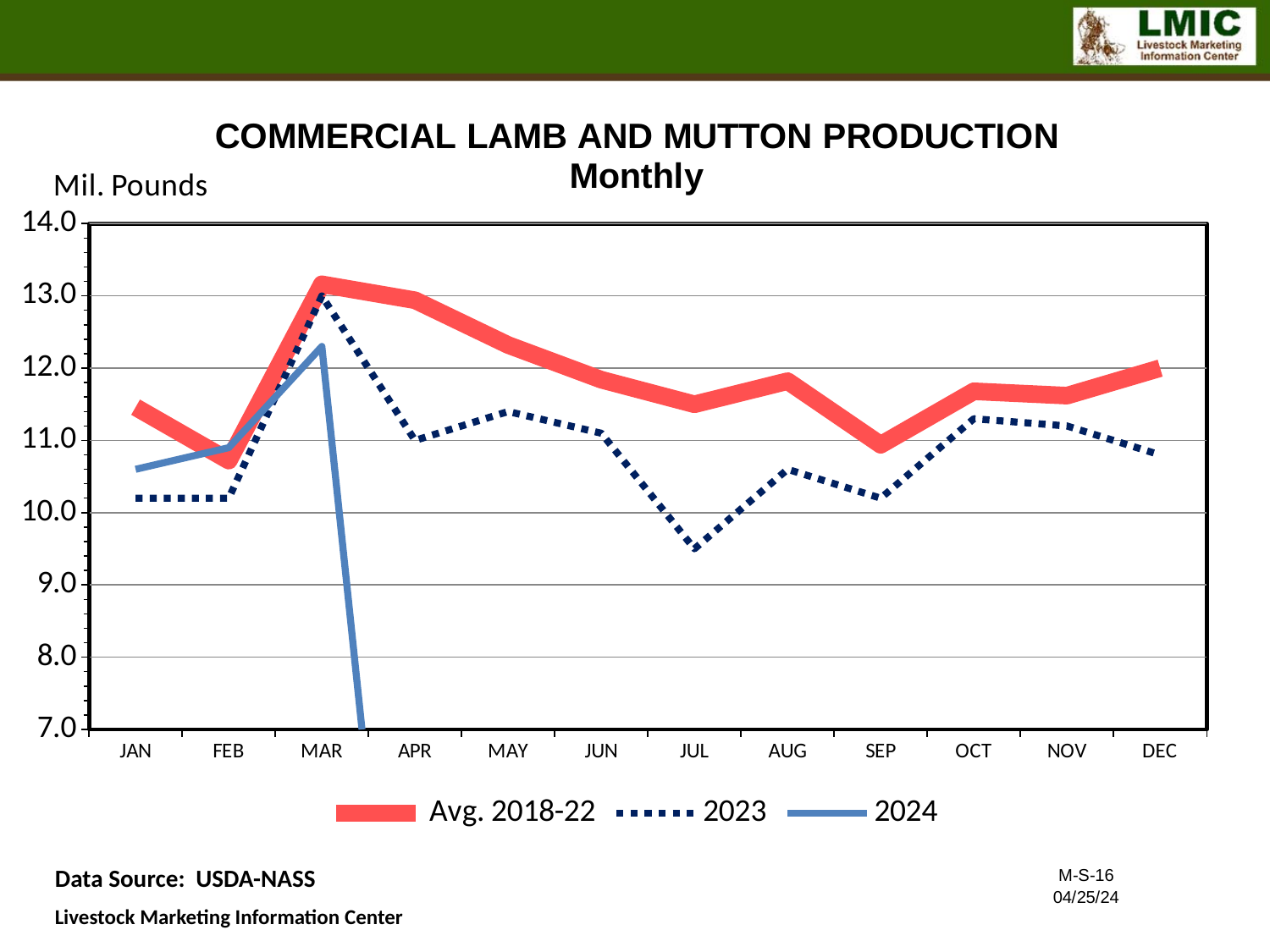
What unit is shown on the y axis label? Mil. Pounds In APR, which series is higher: Avg. 2018-22 or 2023? Avg. 2018-22 Is the Avg. 2018-22 value for JUL greater or less than 11.0? greater Is the 2023 value for JUL greater or less than 10.0? less In which month does the Avg. 2018-22 series reach its highest value? MAR How many months are shown along the x axis? 12 In which month does the 2023 series reach its highest value? MAR Is the 2024 value for JAN greater or less than 10.0? greater How many series does the legend list? 3 Does the 2024 series rise or fall from JAN to MAR? rise What kind of chart is shown on the slide? line chart In which month does the 2023 series reach its lowest value? JUL